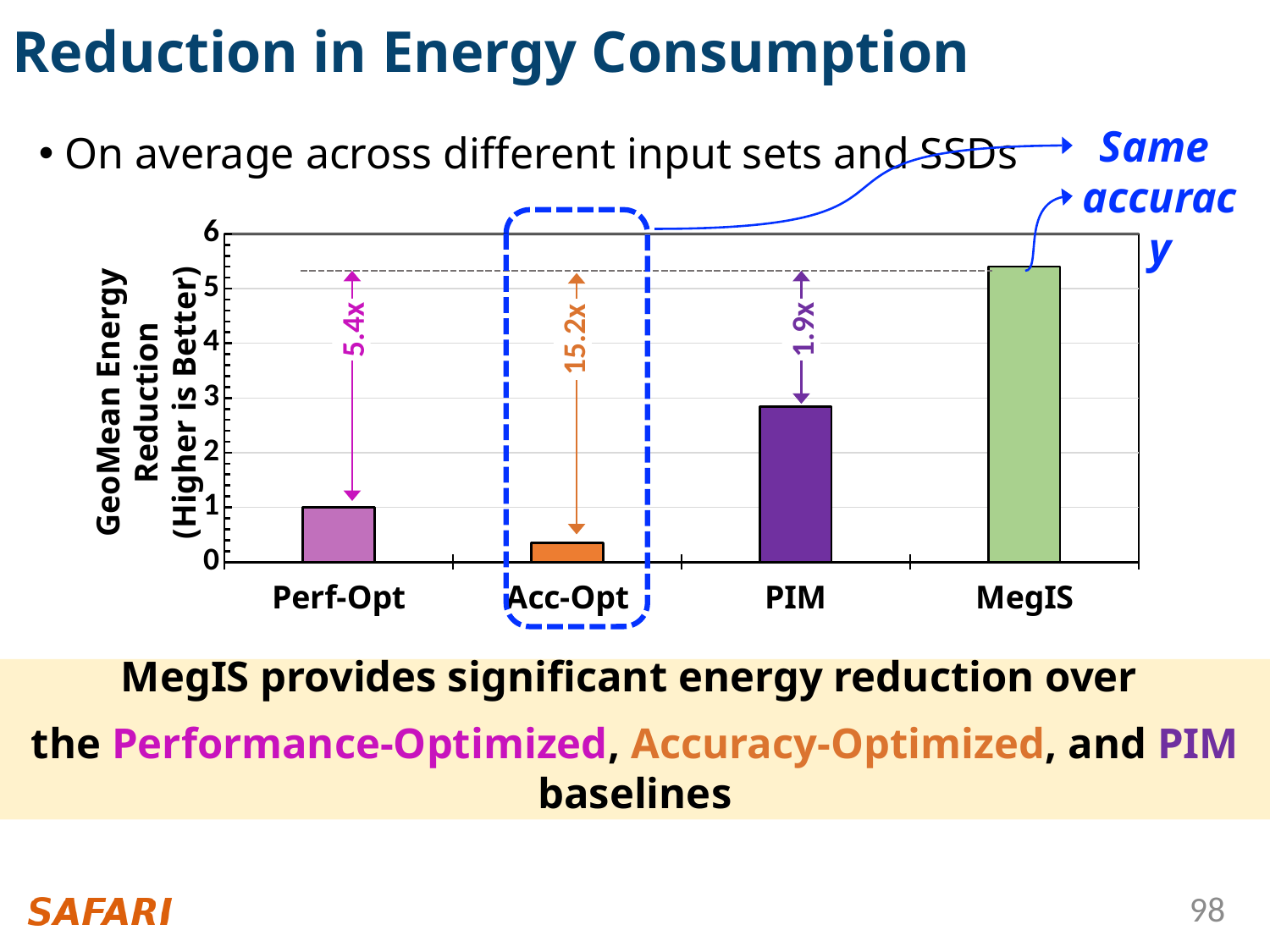
Which has a larger GeoMean Energy Reduction, MegIS or PIM? MegIS What is the GeoMean Energy Reduction value for Perf-Opt? 1 What kind of chart is shown on the slide? bar chart What improvement factor is annotated between the Acc-Opt bar and the MegIS level? 15.2x Is the value for MegIS greater or less than 5? greater Is the value for PIM greater or less than 2? greater What is the y-axis label of the chart? GeoMean Energy Reduction (Higher is Better) Which category has the lowest GeoMean Energy Reduction? Acc-Opt Which has a larger GeoMean Energy Reduction, PIM or Perf-Opt? PIM Is the value for Acc-Opt greater or less than 1? less How many categories are plotted on the x axis of the chart? 4 Which category has the highest GeoMean Energy Reduction? MegIS